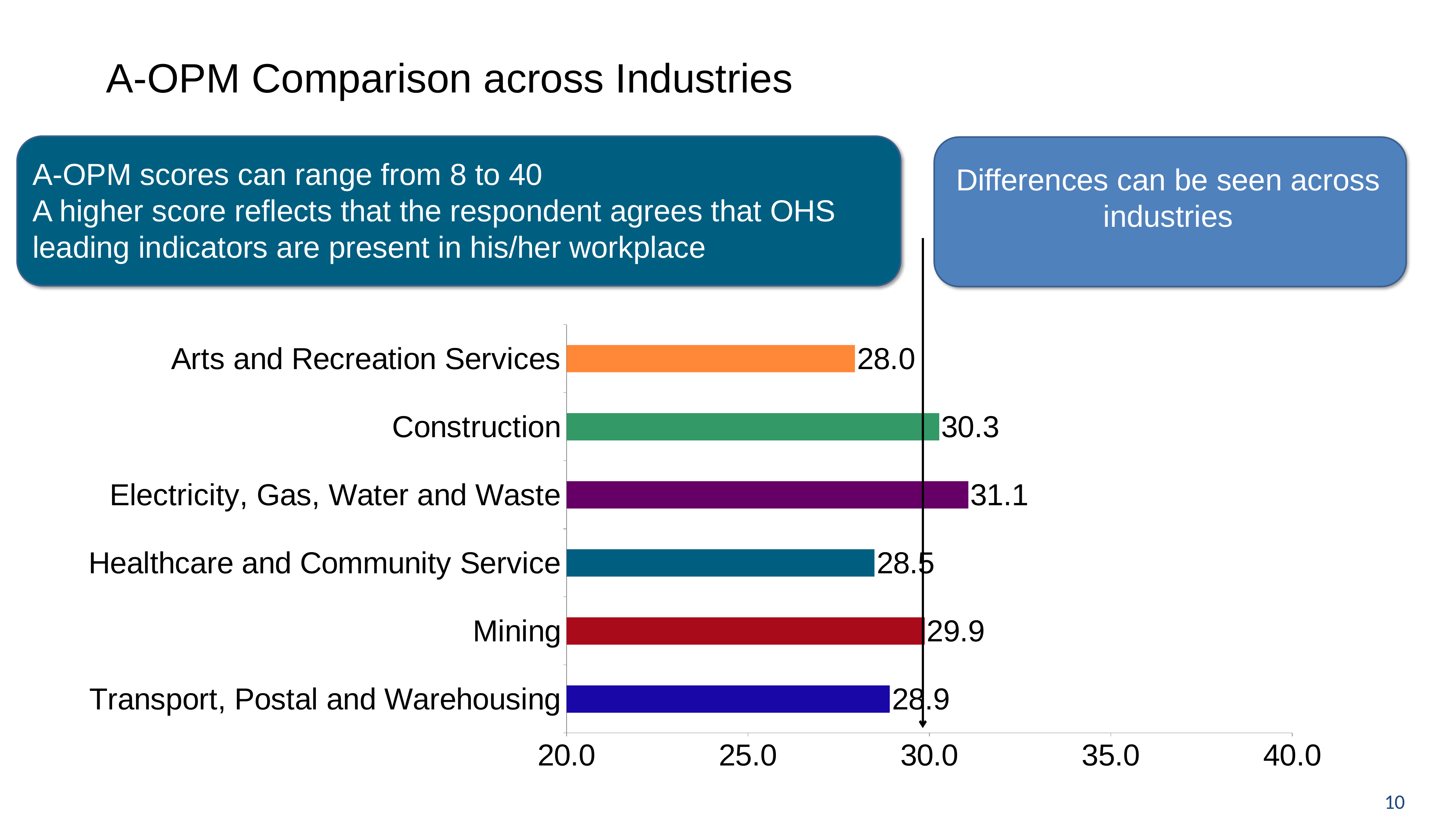
Which industry has the lowest A-OPM score? Arts and Recreation Services What is the A-OPM score for Transport, Postal and Warehousing? 28.9 What is the difference between the A-OPM scores for Construction and Healthcare and Community Service? 1.8 What is the A-OPM score for Construction? 30.3 What kind of chart is shown on the slide? Bar chart Is the A-OPM score for Construction greater or less than 30.0? greater What is the title of the slide containing the chart? A-OPM Comparison across Industries What is the A-OPM score for Mining? 29.9 What is the difference between the A-OPM scores for Electricity, Gas, Water and Waste and Arts and Recreation Services? 3.1 How many industries are shown in the chart? 6 Which has a higher A-OPM score, Mining or Healthcare and Community Service? Mining Which industry has the highest A-OPM score? Electricity, Gas, Water and Waste